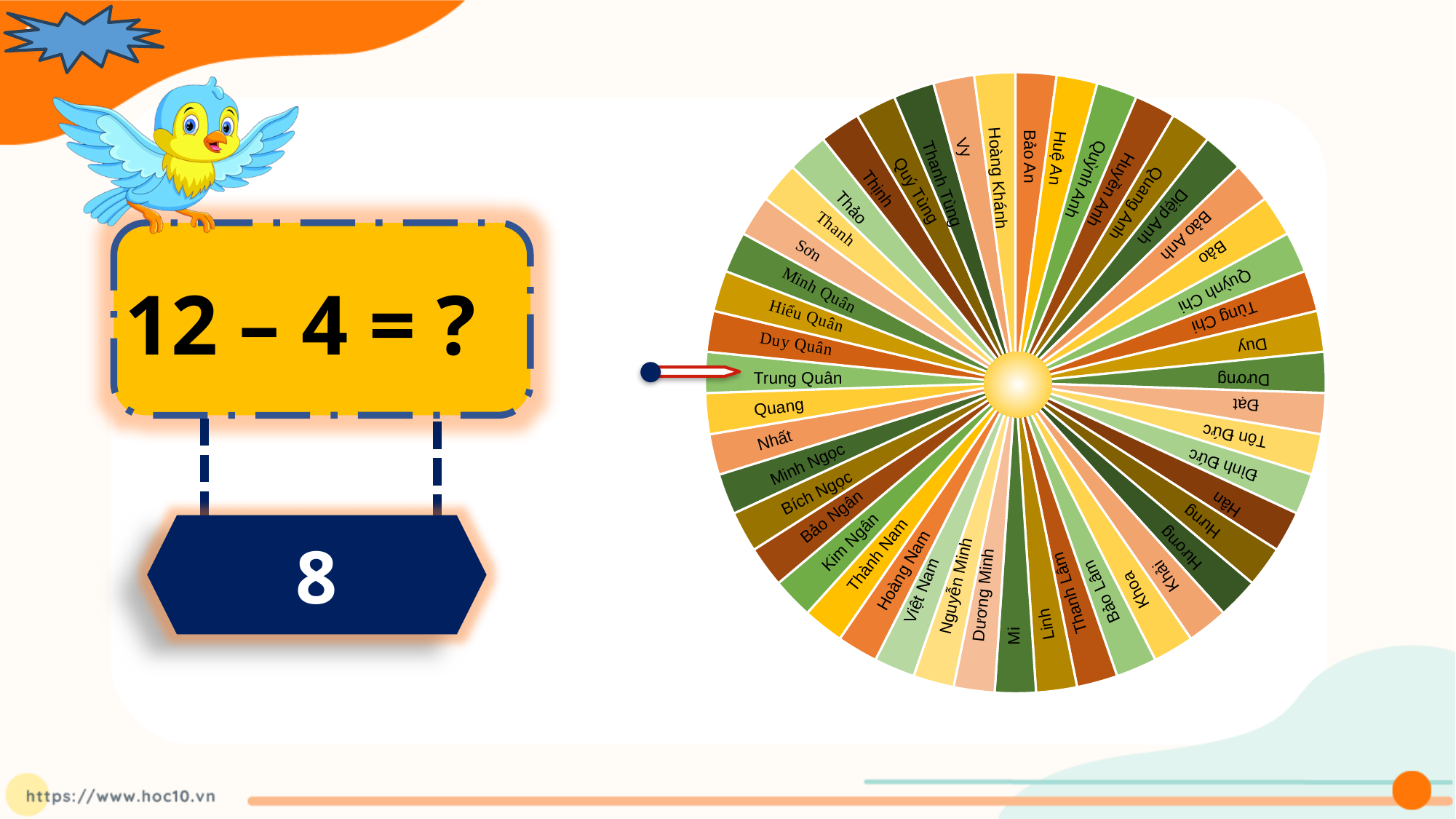
Which slice is directly above the 'Trung Quân' slice on the wheel? Duy Quân Which slice is directly below the 'Trung Quân' slice on the wheel? Quang Which slice of the wheel does the pointer on the left point to? Trung Quân What kind of chart is shown on the right side of the slide? pie chart Which slice is between 'Quỳnh Chi' and 'Duy' on the wheel? Tùng Chi Which slice is between 'Hoàng Nam' and 'Nguyễn Minh' on the wheel? Việt Nam Which slice sits at the very top of the wheel, just left of 'Huệ An'? Bảo An Does the wheel show any numeric values on its slices? No Are the slices of the wheel all the same size, or do they differ? the same size